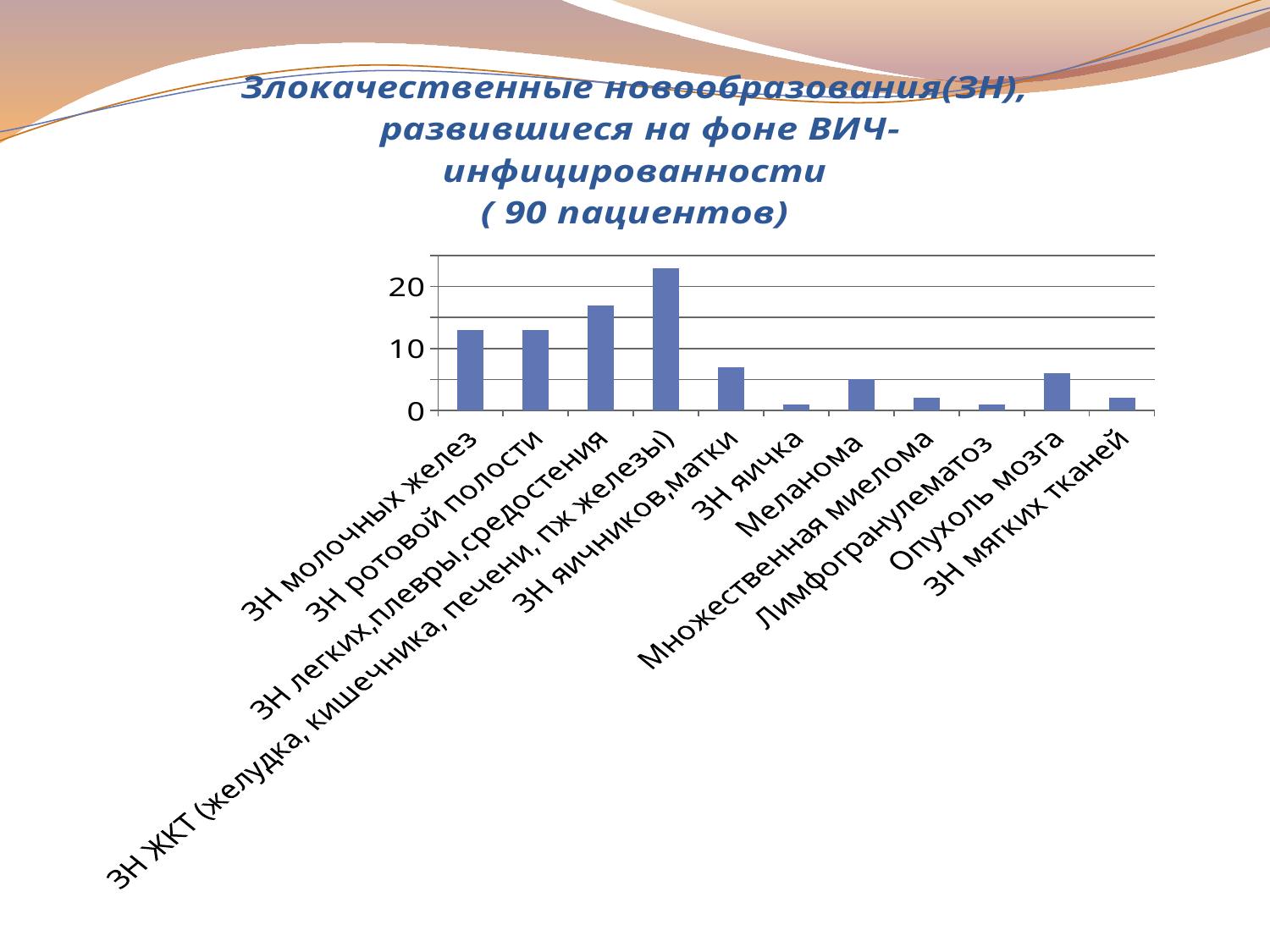
Which is larger, the value for ЗН легких,плевры,средостения or the value for ЗН молочных желез? ЗН легких,плевры,средостения Is the value for Меланома greater or less than 10? less Is the value for ЗН легких,плевры,средостения greater or less than 10? greater Which is larger, the value for ЗН ЖКТ (желудка, кишечника, печени, пж железы) or the value for ЗН легких,плевры,средостения? ЗН ЖКТ (желудка, кишечника, печени, пж железы) How many patients does the chart title say the data covers? 90 пациентов What kind of chart is shown on the slide? bar chart Which is larger, the value for Опухоль мозга or the value for Множественная миелома? Опухоль мозга Is the value for ЗН ЖКТ (желудка, кишечника, печени, пж железы) greater or less than 20? greater Which category has the highest bar? ЗН ЖКТ (желудка, кишечника, печени, пж железы) How many categories are plotted on the chart? 11